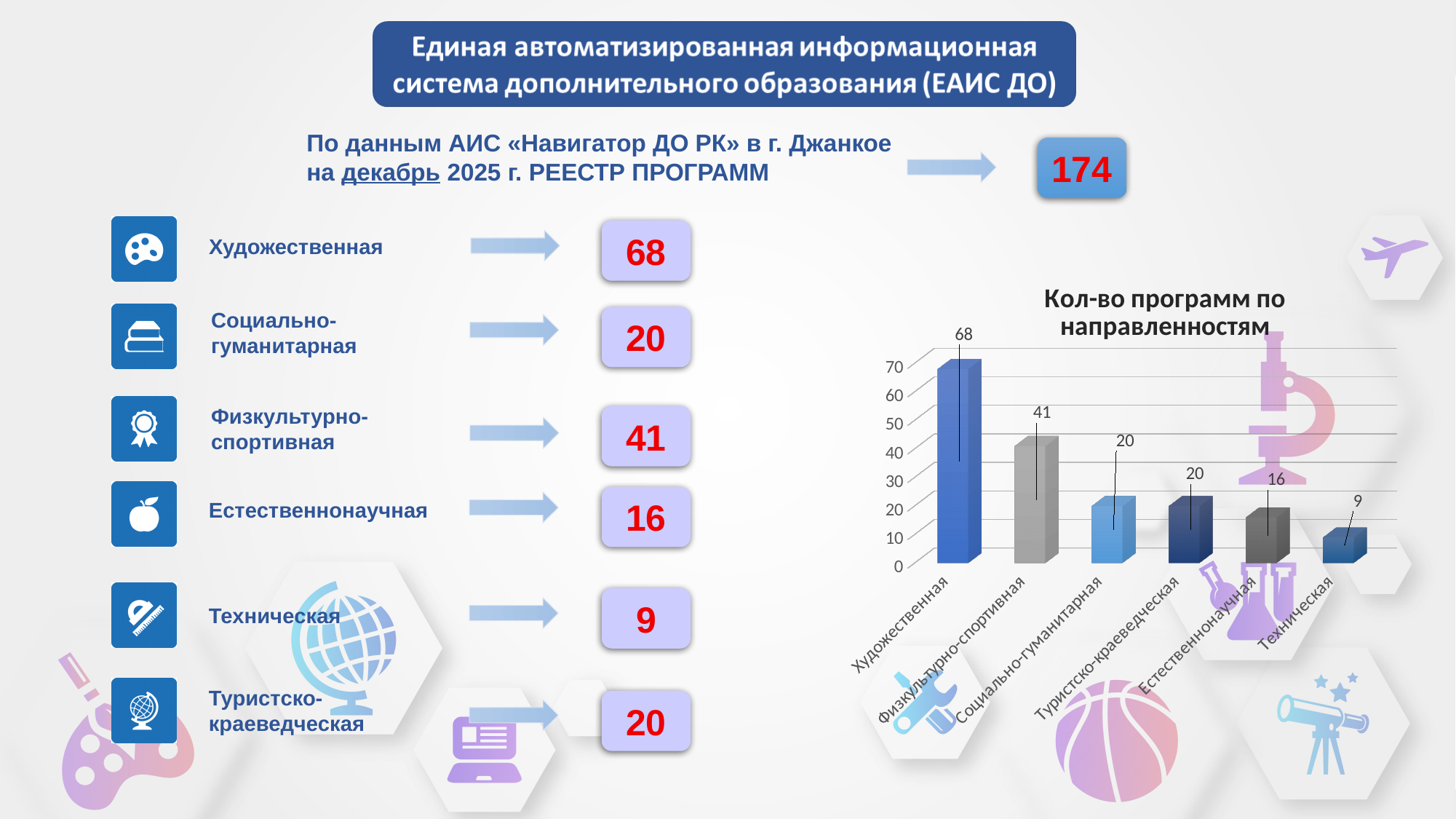
What is the difference between the values for Художественная and Физкультурно-спортивная? 27 Which category has the highest value in the chart? Художественная Do the values rise or fall from left to right along the x axis of the chart? fall Which category has the lowest value in the chart? Техническая What is the title of the chart on the slide? Кол-во программ по направленностям What is the value for Естественнонаучная in the chart? 16 What is the value for Техническая in the chart? 9 How many categories are plotted in the chart? 6 What is the value for Художественная in the chart? 68 What is the value for Физкультурно-спортивная in the chart? 41 What type of chart is shown on the slide? bar chart Which is larger, the value for Естественнонаучная or the value for Туристско-краеведческая? Туристско-краеведческая